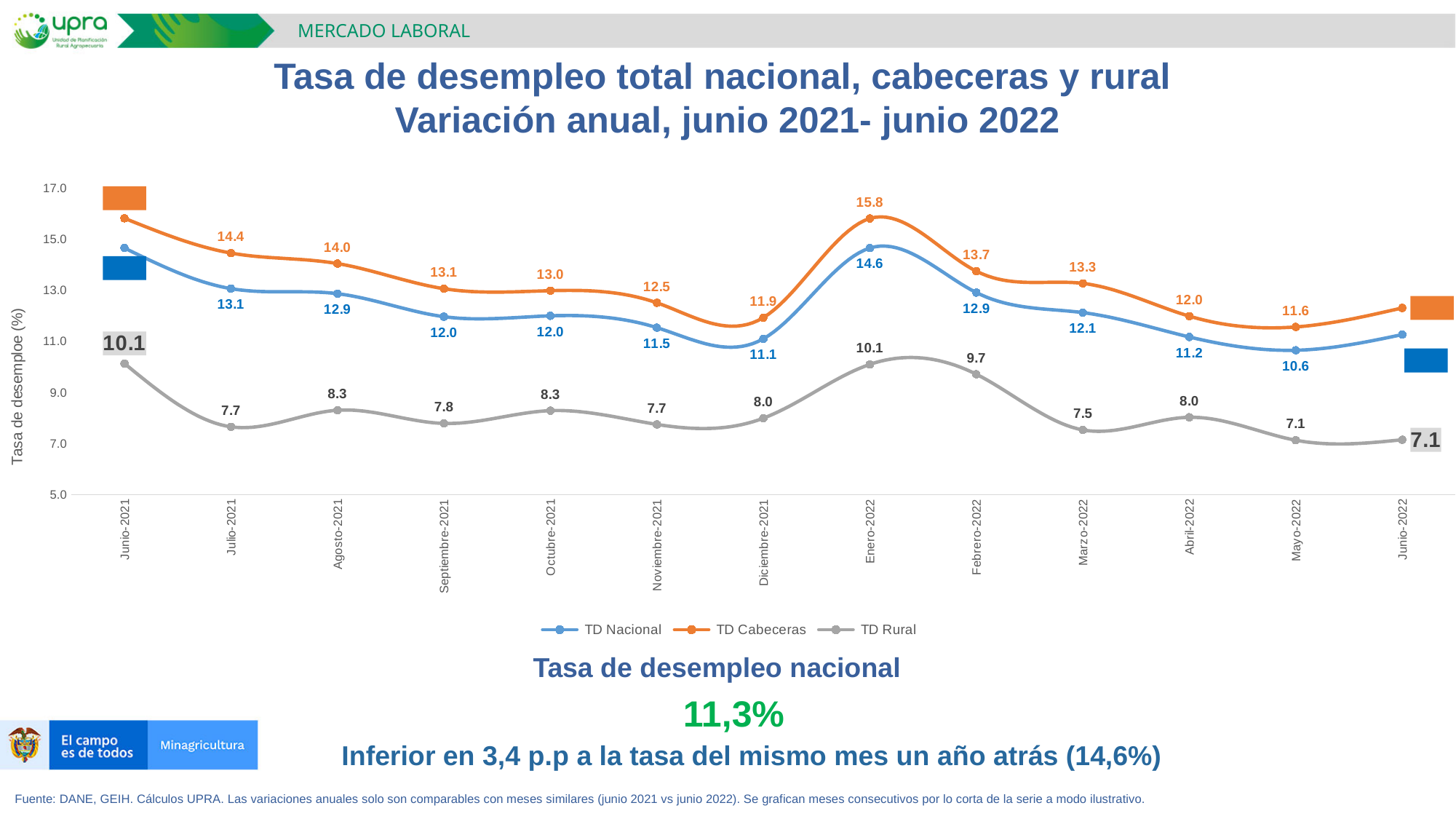
Does TD Nacional rise or fall from Enero-2022 to Mayo-2022? Fall What is the difference between TD Cabeceras and TD Nacional in Enero-2022? 1.2 By how much did TD Rural fall from Junio-2021 to Junio-2022? 3.0 What kind of chart is shown on the slide? Line chart In which month is TD Nacional at its lowest? Mayo-2022 How many months are plotted along the x axis? 13 Which is higher for TD Rural: Agosto-2021 or Septiembre-2021? Agosto-2021 Is the value for TD Cabeceras in Junio-2021 greater or less than 15.0? greater What is the value of TD Rural in Marzo-2022? 7.5 What is the value of TD Cabeceras in Enero-2022? 15.8 How many series does the legend list? 3 What is the value of TD Nacional in Noviembre-2021? 11.5